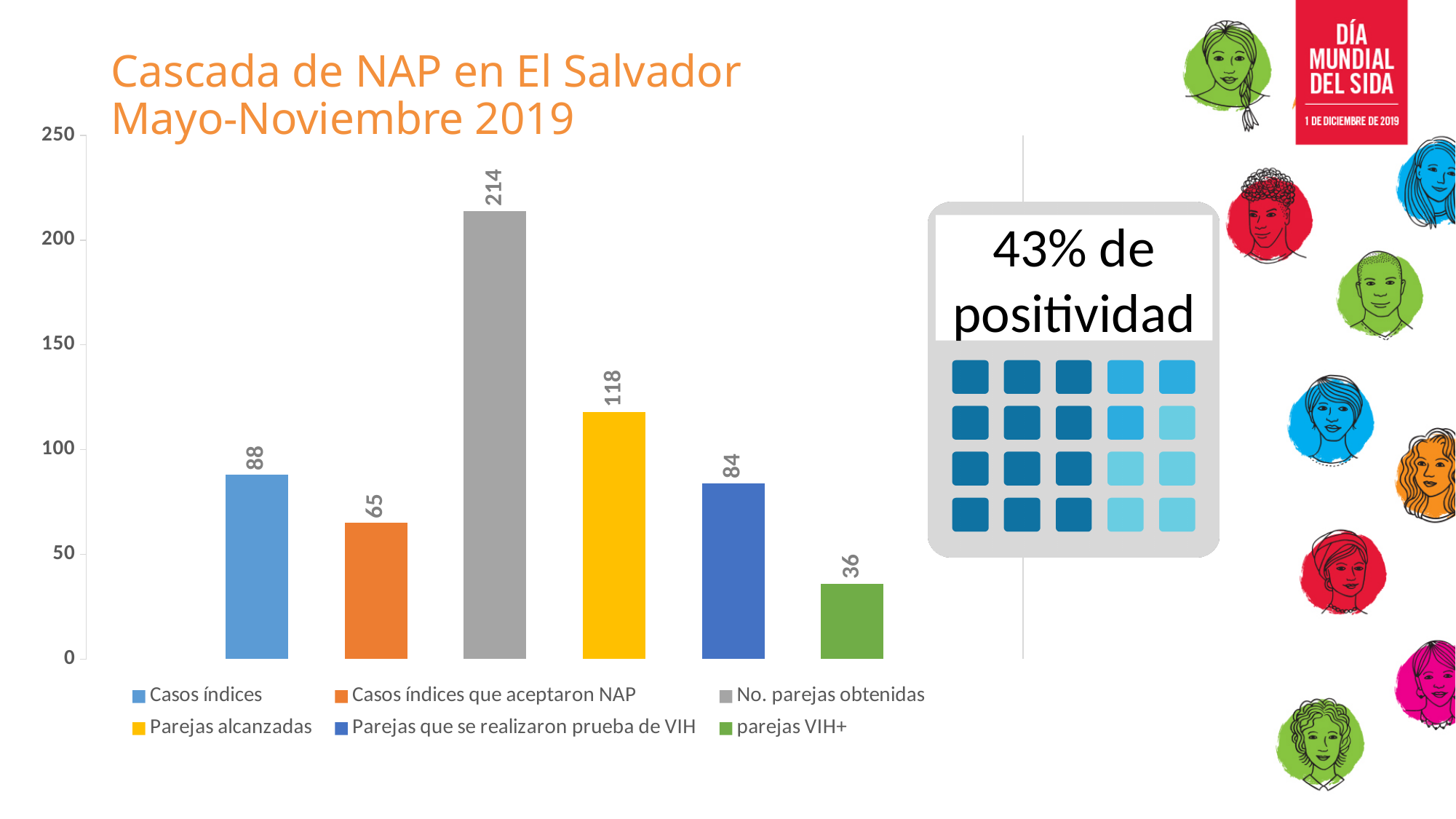
What is the difference between Parejas que se realizaron prueba de VIH and parejas VIH+? 48 What is the value for No. parejas obtenidas? 214 What is the value for Casos índices? 88 What is the value for Parejas que se realizaron prueba de VIH? 84 How many series does the legend list? 6 Which series has the highest value? No. parejas obtenidas What is the difference between No. parejas obtenidas and Parejas alcanzadas? 96 What is the value for Casos índices que aceptaron NAP? 65 Which is larger, Casos índices or Parejas que se realizaron prueba de VIH? Casos índices Which series has the lowest value? parejas VIH+ What is the title of the chart? Cascada de NAP en El Salvador Mayo-Noviembre 2019 What kind of chart is shown on the slide? Bar chart